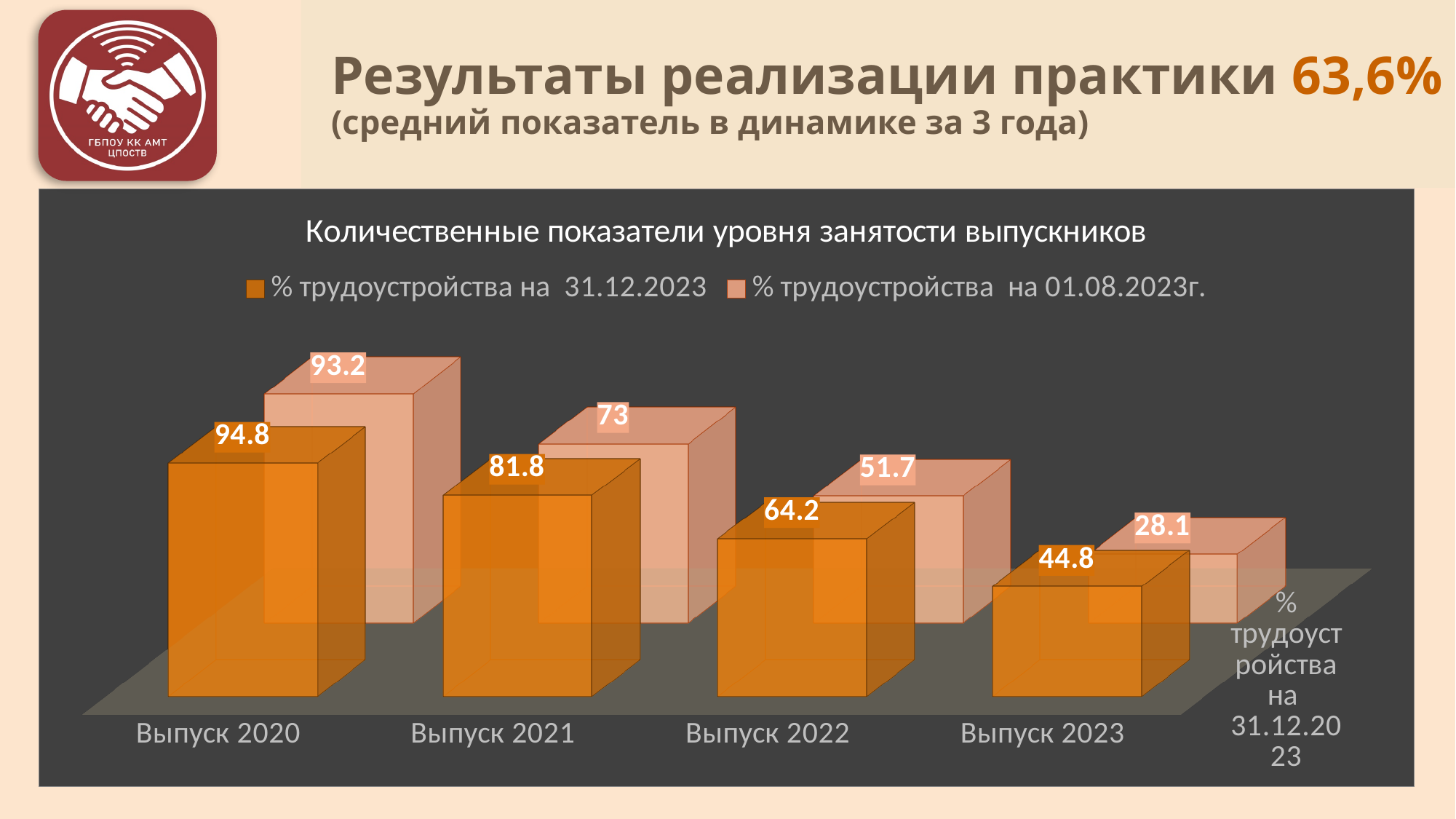
What is the value for Выпуск 2020 in the series % трудоустройства на 31.12.2023? 94.8 How many categories (выпуски) are shown on the x axis of the chart? 4 For Выпуск 2021, which series has the larger value: % трудоустройства на 31.12.2023 or % трудоустройства на 01.08.2023г.? % трудоустройства на 31.12.2023 Do the values in the series % трудоустройства на 31.12.2023 rise or fall from Выпуск 2020 to Выпуск 2023? Fall What is the difference between the two series values for Выпуск 2022? 12.5 What kind of chart is shown on the slide? Bar chart What is the value for Выпуск 2023 in the series % трудоустройства на 31.12.2023? 44.8 Which category has the lowest value in the series % трудоустройства на 01.08.2023г.? Выпуск 2023 How many series does the chart legend list? 2 What is the value for Выпуск 2021 in the series % трудоустройства на 01.08.2023г.? 73 What is the title of the chart? Количественные показатели уровня занятости выпускников Which category has the highest value in the series % трудоустройства на 31.12.2023? Выпуск 2020